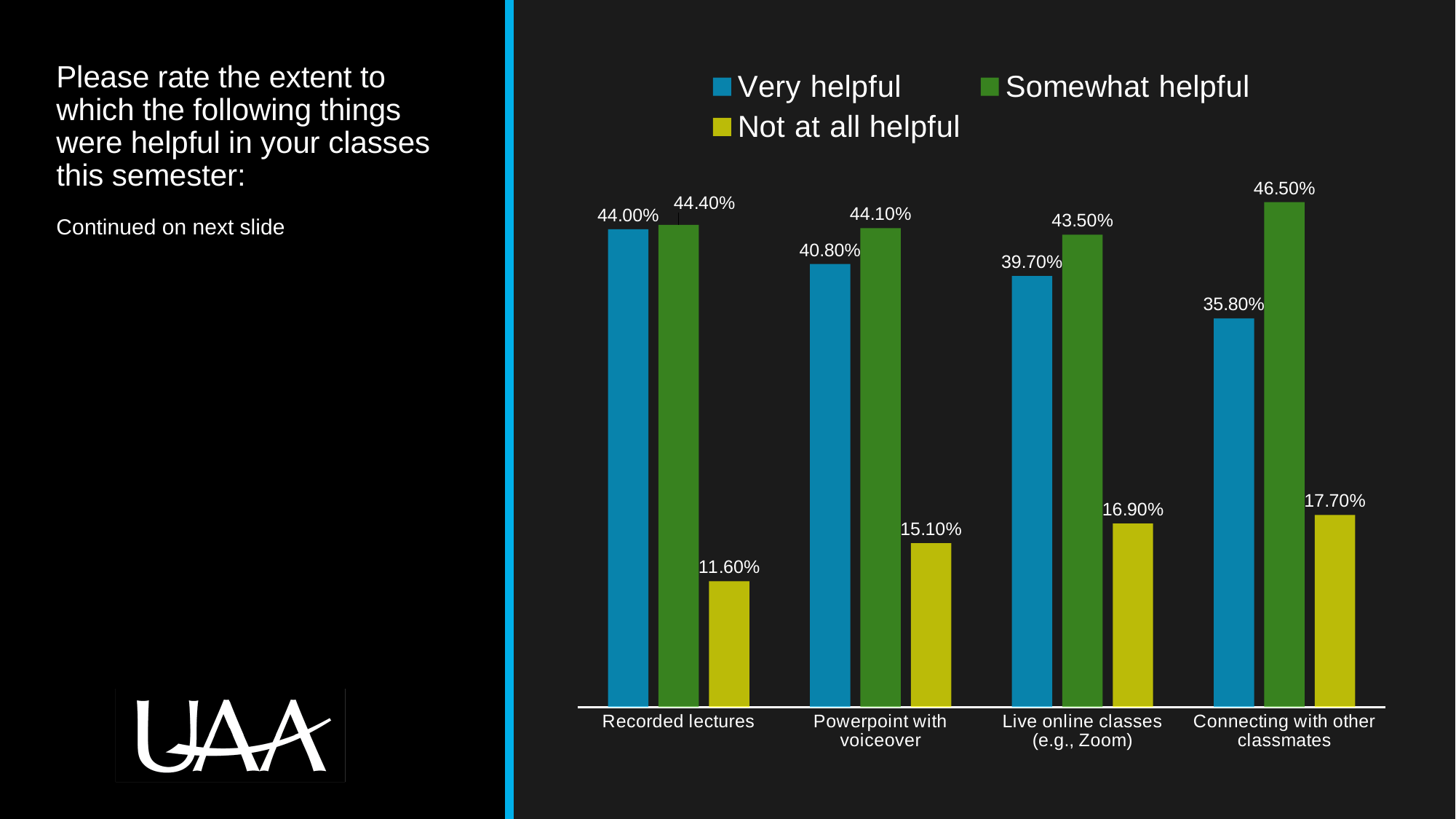
Which is larger: the 'Not at all helpful' value for Powerpoint with voiceover or for recorded lectures? Powerpoint with voiceover What percentage rated Powerpoint with voiceover as very helpful? 40.80% How many categories are shown on the x axis? 4 Which category has the lowest 'Very helpful' value? Connecting with other classmates How many series does the legend list? 3 What percentage rated connecting with other classmates as somewhat helpful? 46.50% What kind of chart is shown on the slide? Bar chart What percentage rated recorded lectures as very helpful? 44.00% What percentage rated live online classes (e.g., Zoom) as not at all helpful? 16.90% Which category has the highest 'Somewhat helpful' value? Connecting with other classmates What is the difference between the 'Somewhat helpful' and 'Very helpful' values for connecting with other classmates? 10.70% Which category has the lowest 'Not at all helpful' value? Recorded lectures